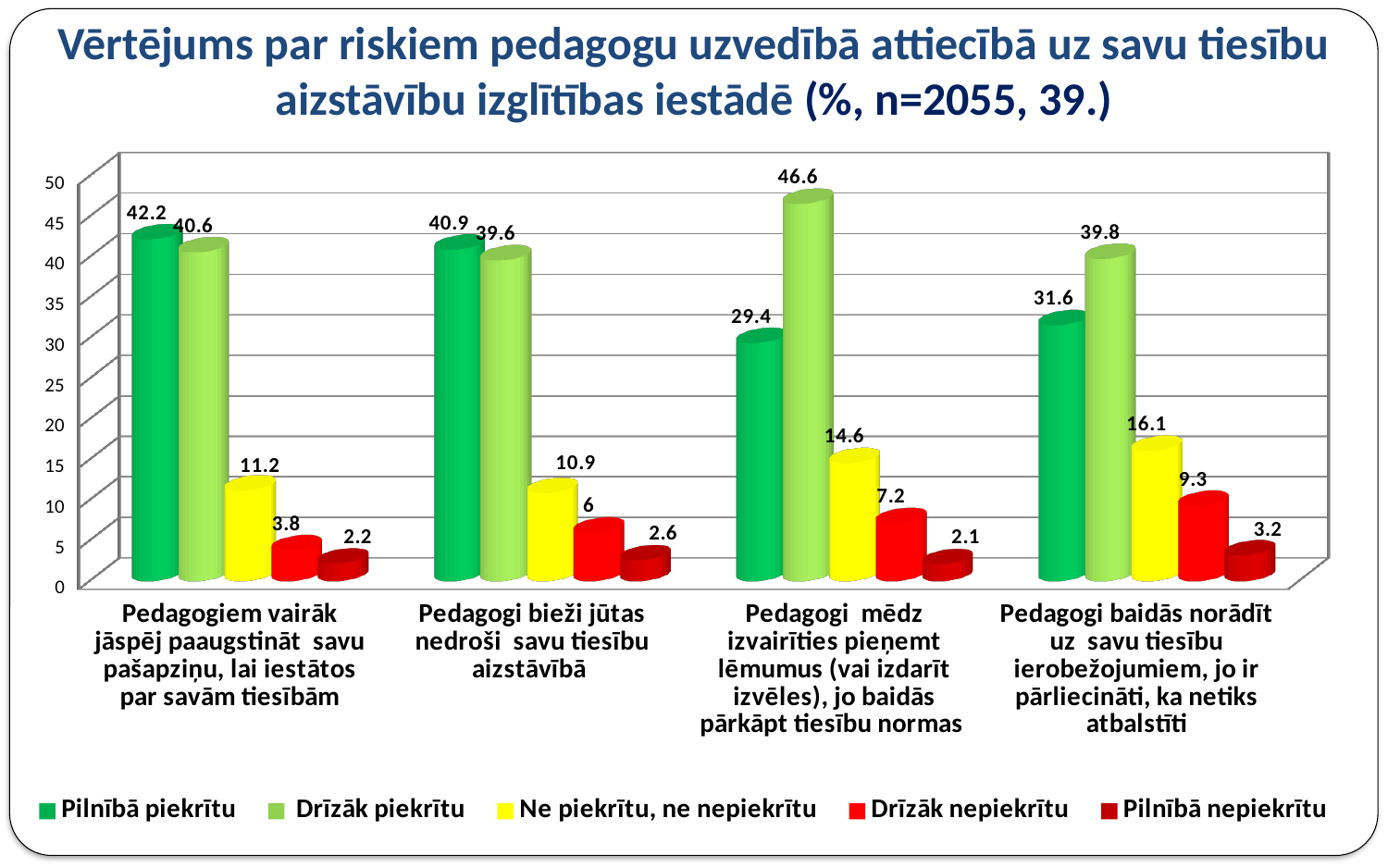
Which is larger for "Pedagogi baidās norādīt uz savu tiesību ierobežojumiem, jo ir pārliecināti, ka netiks atbalstīti": "Pilnībā piekrītu" or "Drīzāk piekrītu"? Drīzāk piekrītu How many series does the legend list? 5 What is the value of "Ne piekrītu, ne nepiekrītu" for "Pedagogi baidās norādīt uz savu tiesību ierobežojumiem, jo ir pārliecināti, ka netiks atbalstīti"? 16.1 How many categories are shown on the x axis? 4 What type of chart is shown on the slide? bar chart What is the difference between "Drīzāk piekrītu" and "Pilnībā piekrītu" for "Pedagogi mēdz izvairīties pieņemt lēmumus (vai izdarīt izvēles), jo baidās pārkāpt tiesību normas"? 17.2 What is the value of "Pilnībā piekrītu" for "Pedagogi bieži jūtas nedroši savu tiesību aizstāvībā"? 40.9 What is the value of "Drīzāk piekrītu" for "Pedagogi mēdz izvairīties pieņemt lēmumus (vai izdarīt izvēles), jo baidās pārkāpt tiesību normas"? 46.6 Is the value of "Pilnībā piekrītu" for "Pedagogi mēdz izvairīties pieņemt lēmumus (vai izdarīt izvēles), jo baidās pārkāpt tiesību normas" greater or less than 30? less Which category has the lowest value for "Pilnībā nepiekrītu"? Pedagogi mēdz izvairīties pieņemt lēmumus (vai izdarīt izvēles), jo baidās pārkāpt tiesību normas What colour are the bars for the "Ne piekrītu, ne nepiekrītu" series? yellow Which category has the highest value for "Pilnībā piekrītu"? Pedagogiem vairāk jāspēj paaugstināt savu pašapziņu, lai iestātos par savām tiesībām